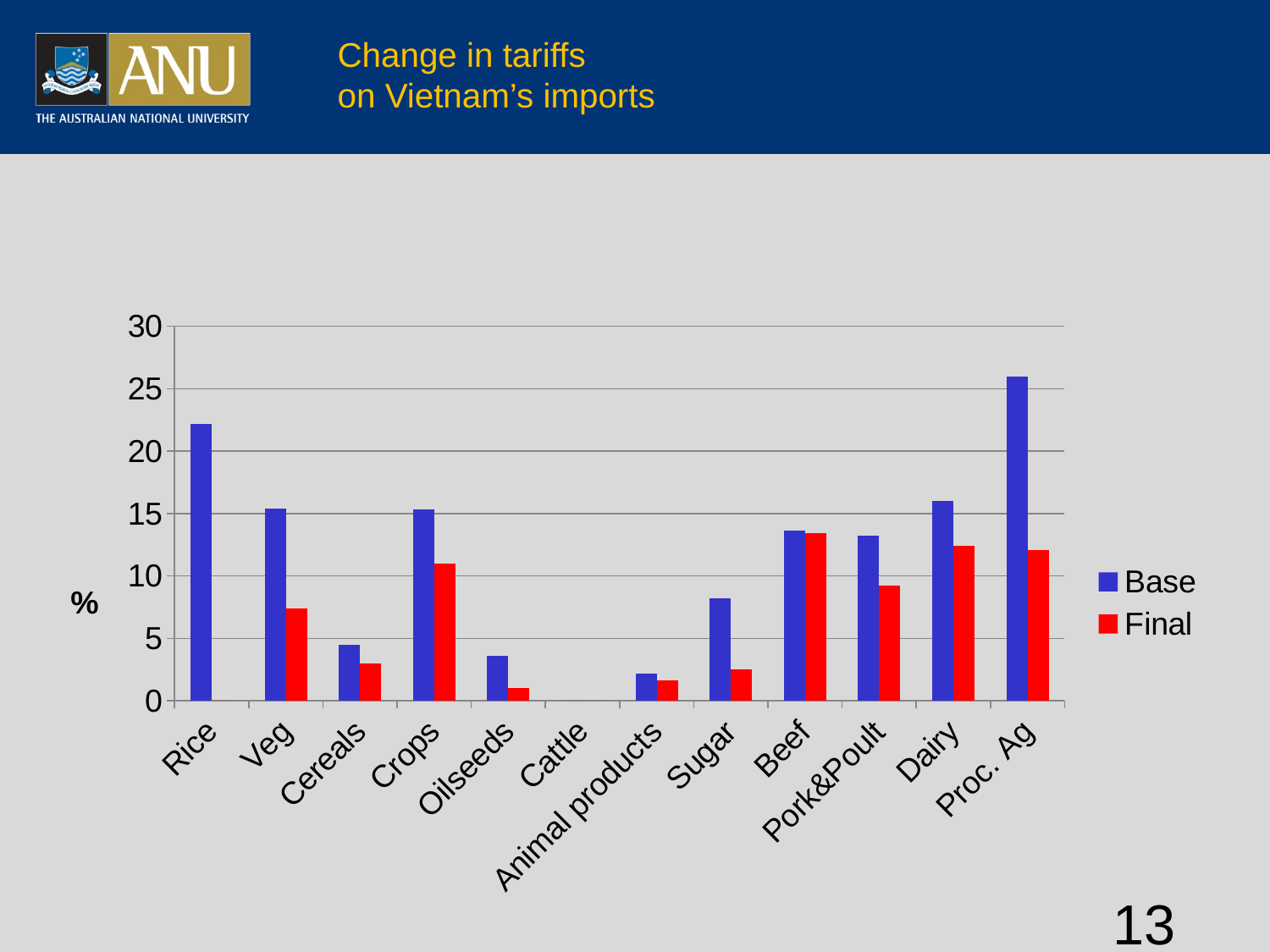
What kind of chart is shown on the slide? bar chart How many series does the legend list? 2 Which category has the highest Base value? Proc. Ag Is the Final value for Veg greater or less than 10? less Is the Base value for Sugar greater or less than 10? less Is the Base value for Rice greater or less than 20? greater Which is larger, the Base value for Rice or the Base value for Veg? Rice Which category has the highest Final value? Beef How many categories are shown on the x axis? 12 What is the label on the vertical axis of the chart? % Which is larger, the Final value for Crops or the Final value for Sugar? Crops